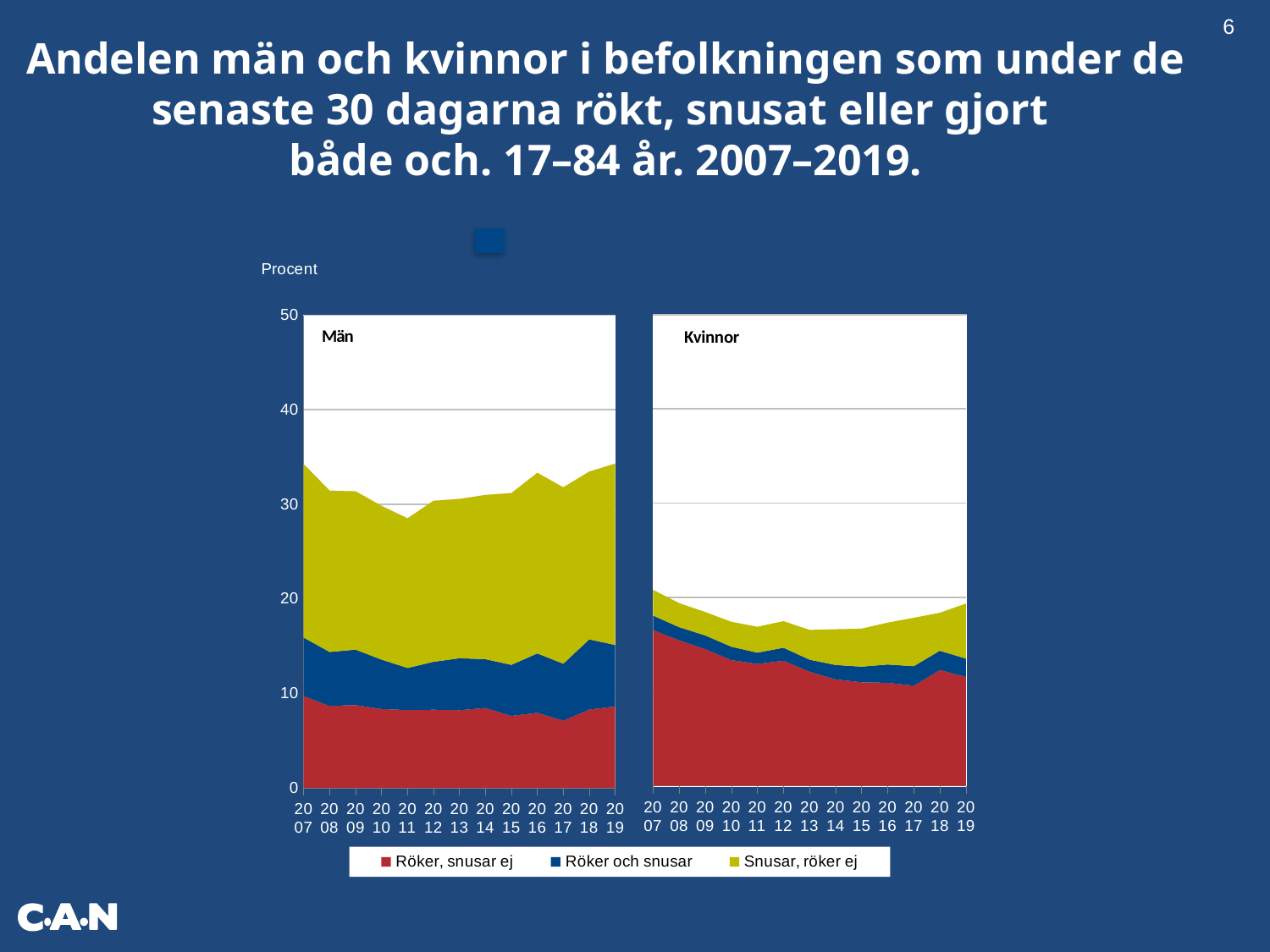
In the Män chart, is the total value for 2007 greater or less than 30? greater In the Kvinnor chart, is the total value for 2013 greater or less than 20? less What is the label on the y axis of the charts? Procent In the Kvinnor chart, does the 'Röker, snusar ej' series rise or fall from 2007 to 2019? fall In the Kvinnor chart, which year has the highest total value? 2007 Which chart has the larger total value in 2007, Män or Kvinnor? Män In the Kvinnor chart, is the value for 'Röker, snusar ej' in 2019 greater or less than 10? greater What kind of chart is used for the Män panel? stacked area chart How many series does the legend list? 3 In the Kvinnor chart, how many years are shown on the x axis? 13